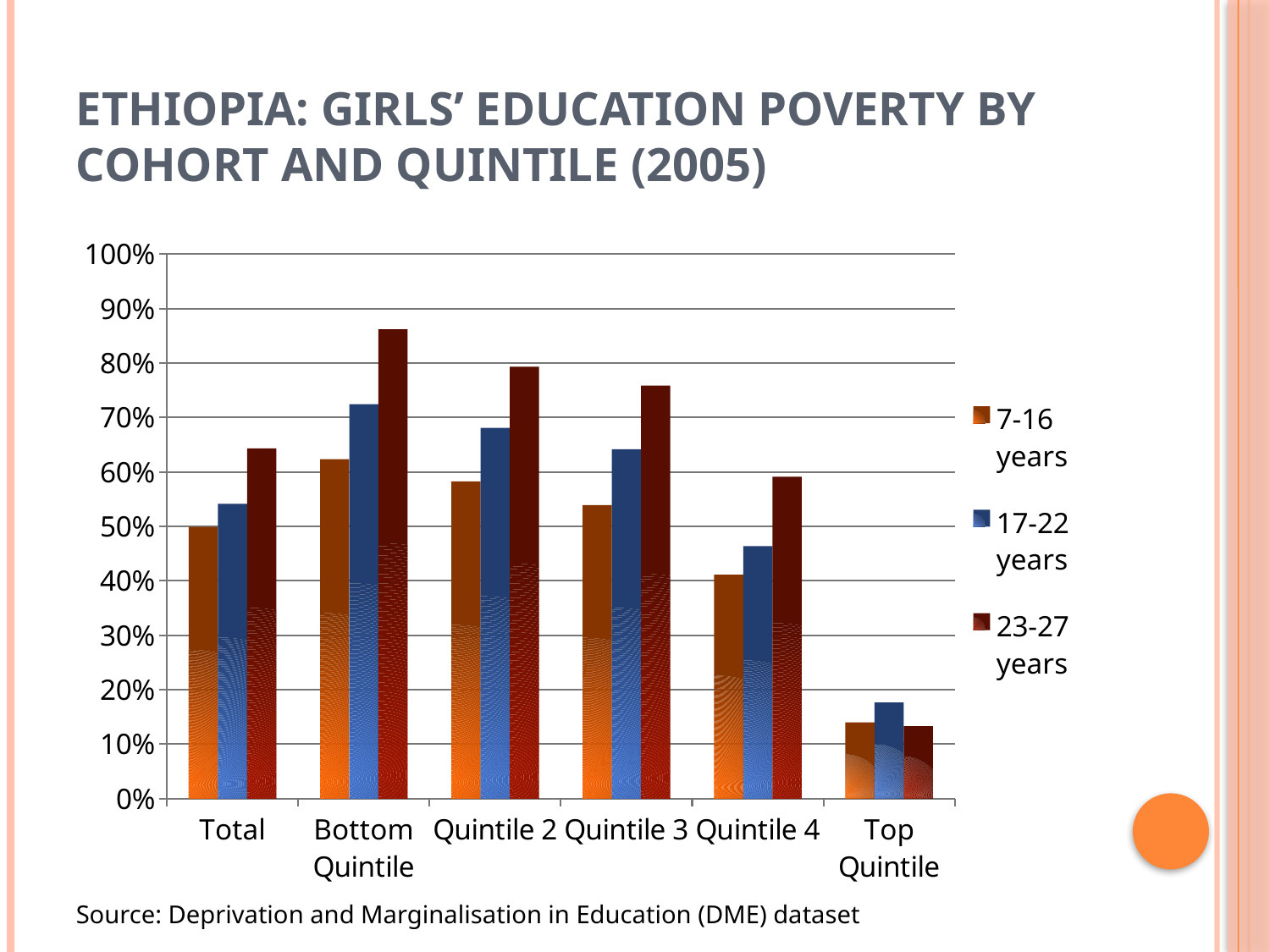
Is the value for 23-27 years in Quintile 3 greater or less than 70%? greater How many series does the legend list? 3 Is the value for 17-22 years in the Top Quintile greater or less than 20%? less Do the 23-27 years values rise or fall moving from the Bottom Quintile to the Top Quintile? fall How many categories are shown along the x axis? 6 Which category has the lowest value for the 7-16 years series? Top Quintile Which category has the highest value for the 23-27 years series? Bottom Quintile Is the value for 23-27 years in the Bottom Quintile greater or less than 80%? greater Which is larger for the 17-22 years series: Quintile 2 or Quintile 3? Quintile 2 What kind of chart is shown on the slide? bar chart What are the three series listed in the legend? 7-16 years, 17-22 years, 23-27 years